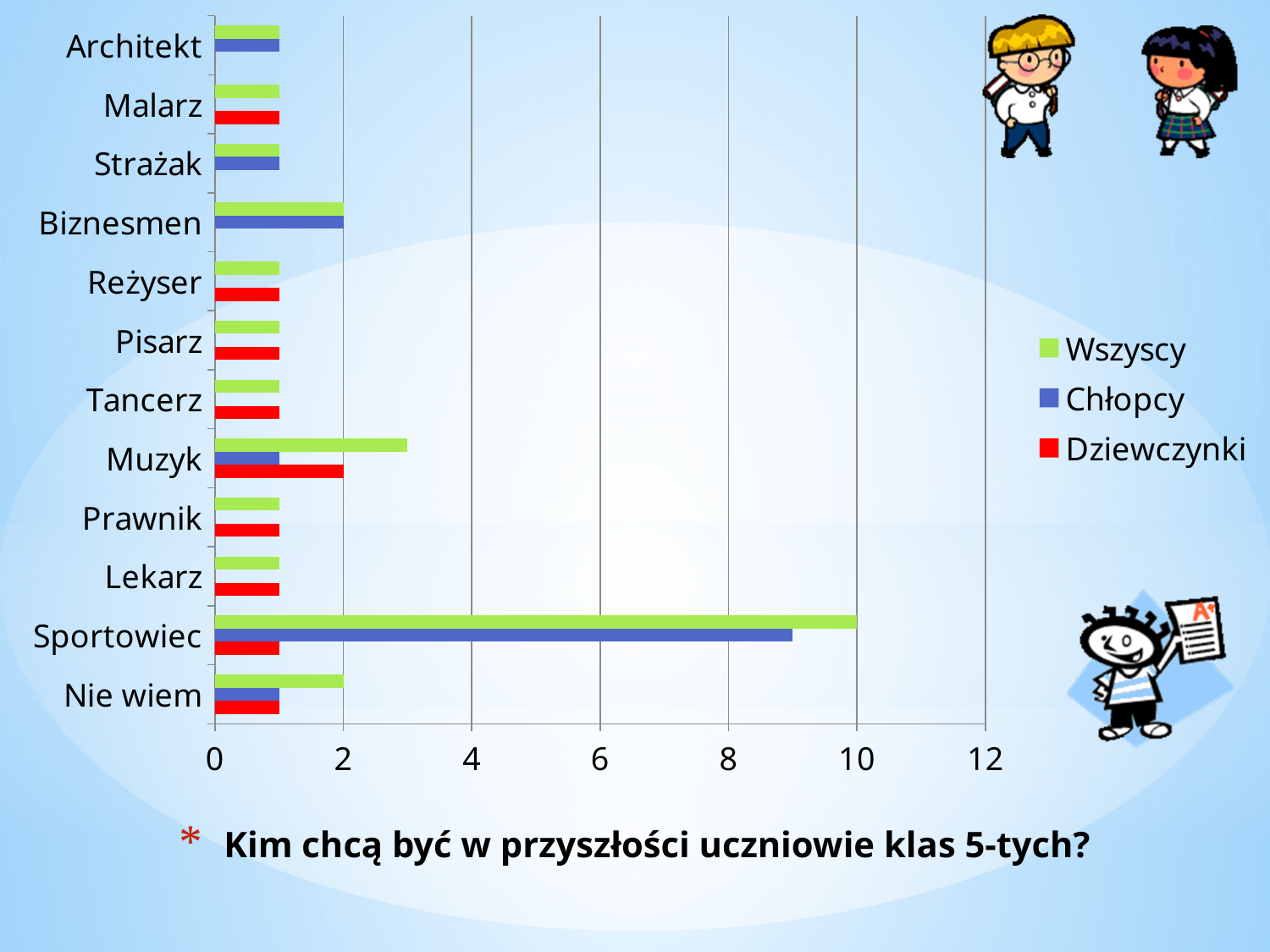
What is the Wszyscy value for Sportowiec? 10 How many categories (professions) are shown on the chart? 12 What kind of chart is shown on the slide? bar chart Is the Chłopcy value for Sportowiec greater or less than 8? greater Is the Wszyscy value for Muzyk greater or less than 2? greater What is the Wszyscy value for Biznesmen? 2 For Sportowiec, which is larger: the Chłopcy value or the Dziewczynki value? Chłopcy Which category has the highest Wszyscy value? Sportowiec What is the Dziewczynki value for Muzyk? 2 Which colour represents the Dziewczynki series in the legend? red How many series does the legend list? 3 What is the Wszyscy value for Nie wiem? 2